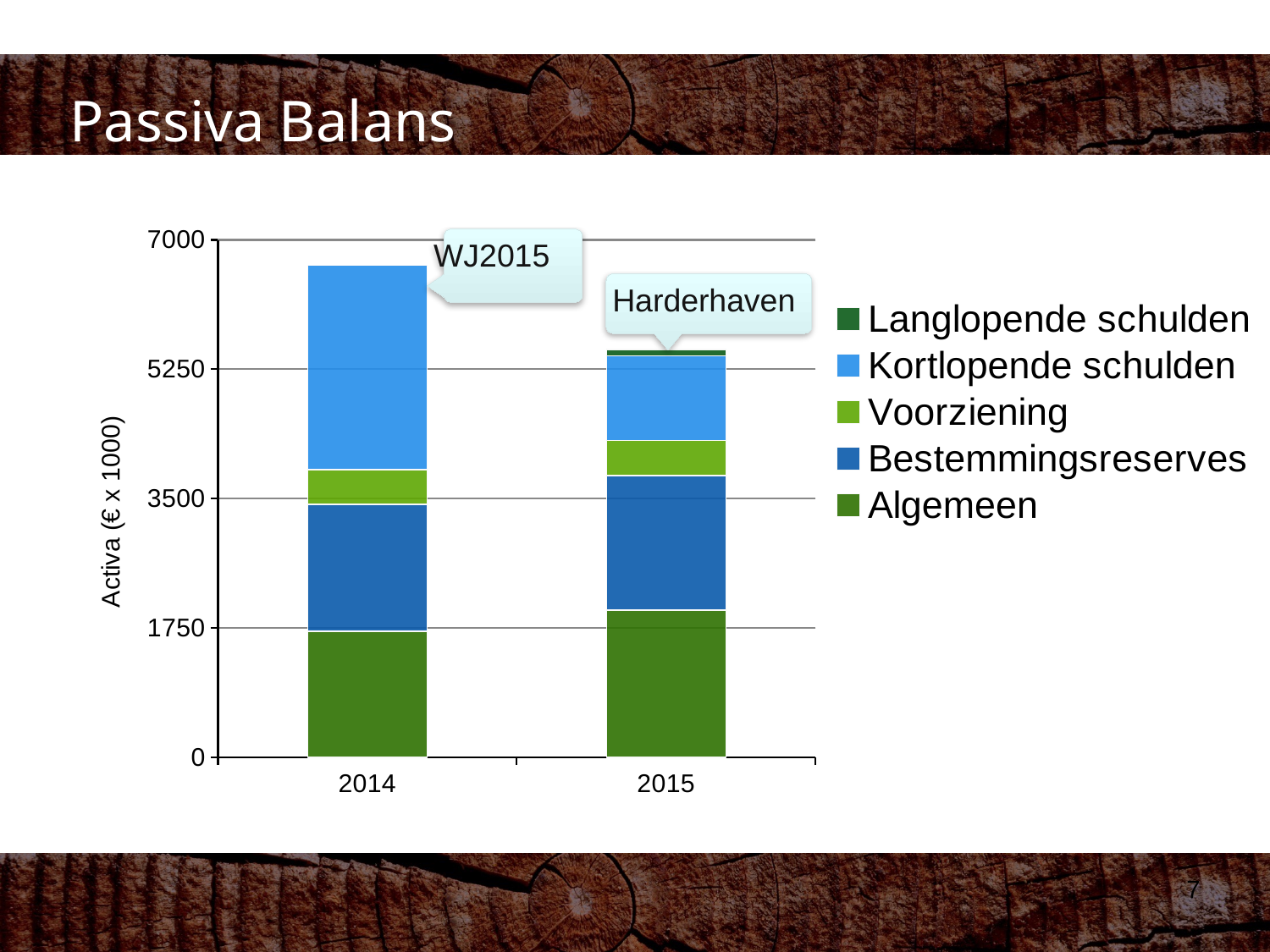
What is the title of the vertical axis of the chart? Activa (€ x 1000) How many categories are shown on the x axis of the chart? 2 What kind of chart is shown on the slide? bar chart Is the total of the 2014 stacked bar greater or less than 5250? greater Which legend entry is listed first in the chart's legend? Langlopende schulden Which year has the larger Kortlopende schulden segment, 2014 or 2015? 2014 Is the value for Algemeen in 2015 greater or less than 1750? greater Which year has the taller stacked bar, 2014 or 2015? 2014 How many series does the chart's legend list? 5 Is the total of the 2015 stacked bar greater or less than 7000? less Does the total height of the stacked bars rise or fall from 2014 to 2015? fall